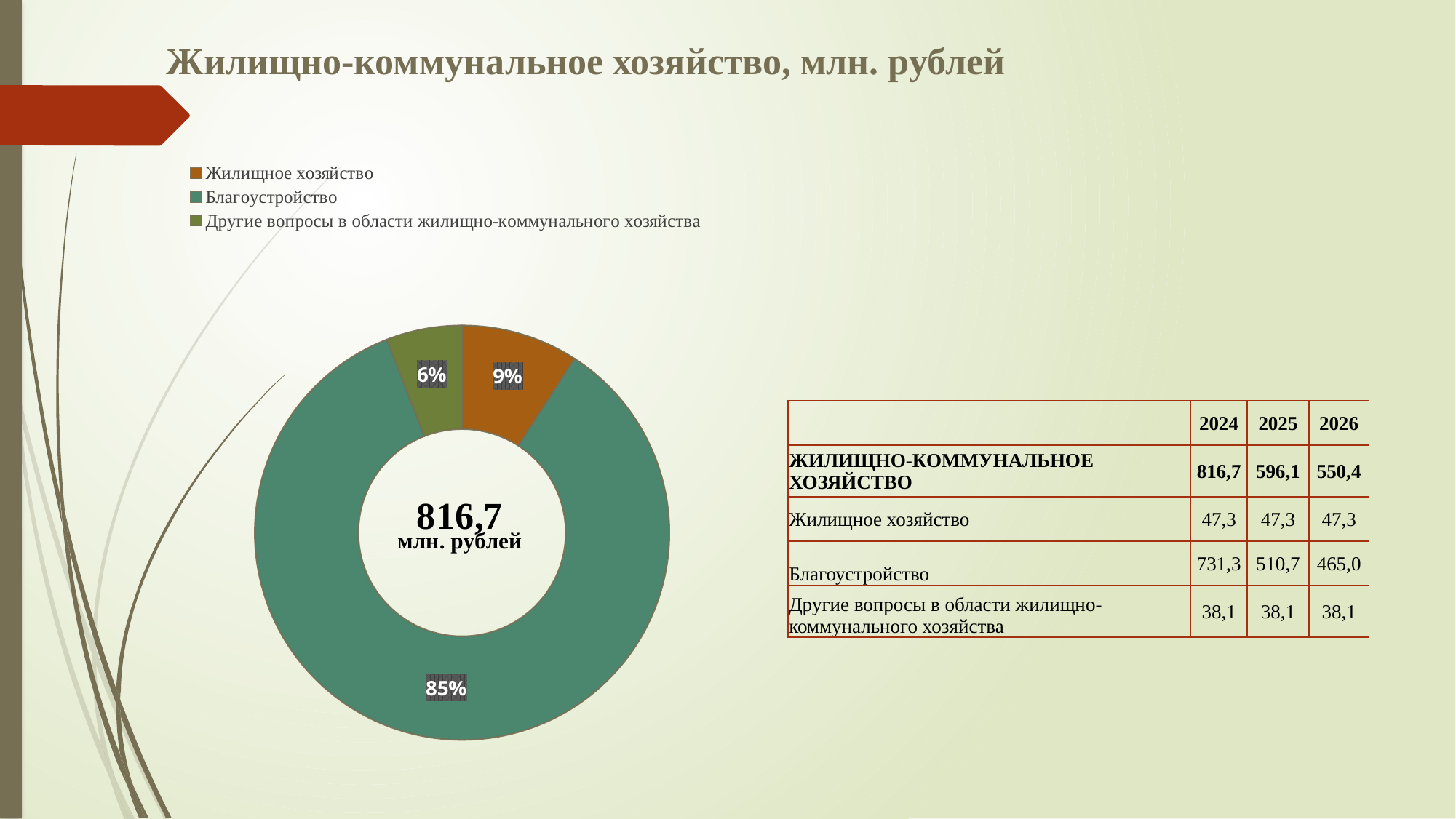
Which category has the smallest slice in the donut chart? Другие вопросы в области жилищно-коммунального хозяйства What share of the donut chart does Жилищное хозяйство account for? 9% What share of the donut chart does Благоустройство account for? 85% Which slice is larger in the donut chart: Жилищное хозяйство or Другие вопросы в области жилищно-коммунального хозяйства? Жилищное хозяйство How many slices does the donut chart have? 3 Which category has the largest slice in the donut chart? Благоустройство What total value is printed in the centre of the donut chart? 816,7 млн. рублей What colour is the Благоустройство slice in the donut chart? Teal green What kind of chart is shown on the slide? Donut (pie) chart How many entries does the chart legend list? 3 What share of the donut chart does Другие вопросы в области жилищно-коммунального хозяйства account for? 6% What is the difference in percentage points between the Благоустройство slice and the Жилищное хозяйство slice? 76%